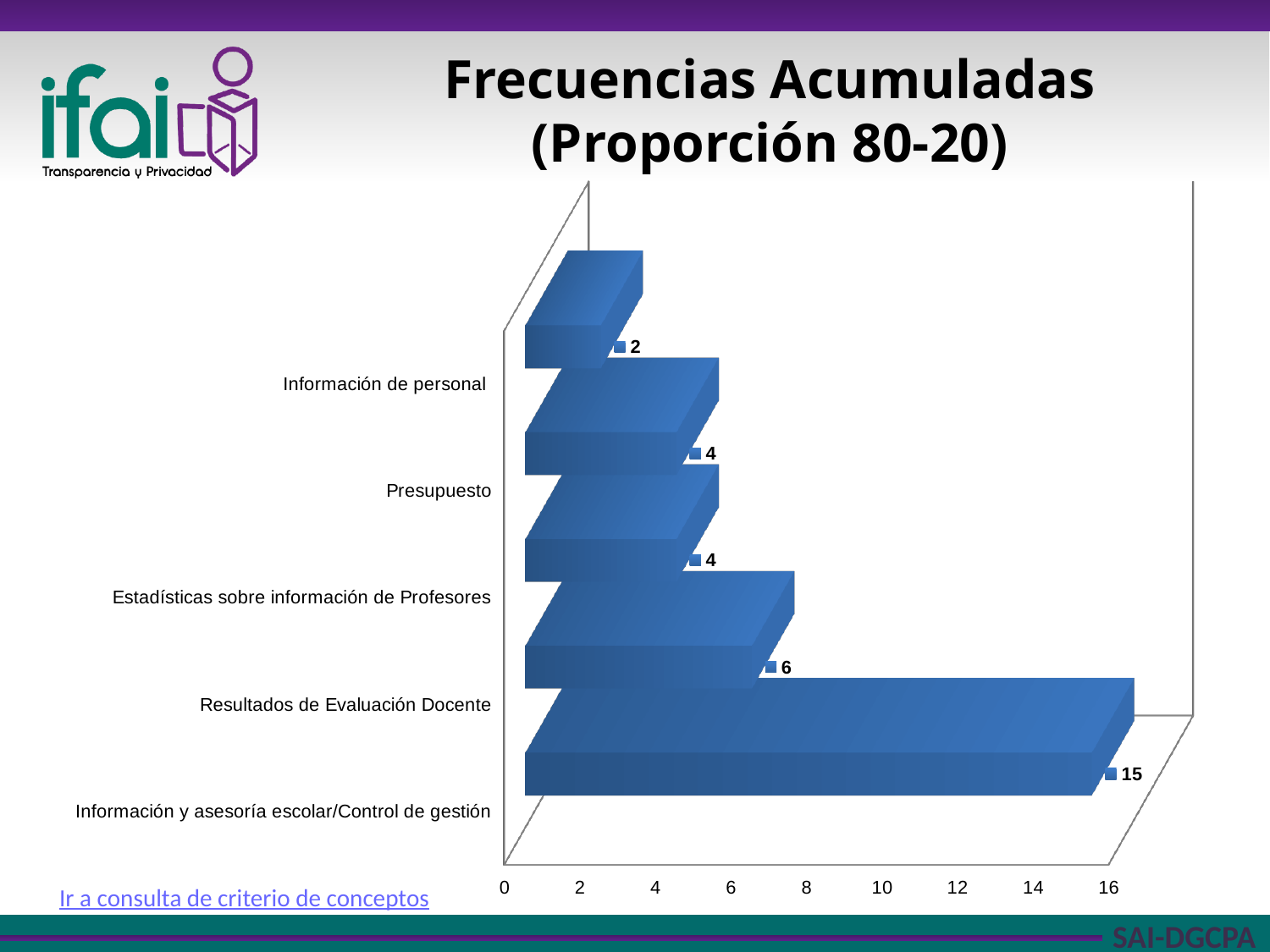
Which category has the highest value? Información y asesoría escolar/Control de gestión What is the value for Información y asesoría escolar/Control de gestión? 15 What is the value for Presupuesto? 4 Which category has the lowest value? Información de personal Which is larger, the value for Resultados de Evaluación Docente or the value for Presupuesto? Resultados de Evaluación Docente What is the title of the chart? Frecuencias Acumuladas (Proporción 80-20) What kind of chart is shown on the slide? bar chart How many categories are shown in the chart? 5 What is the value for Resultados de Evaluación Docente? 6 Is the value for Información y asesoría escolar/Control de gestión greater or less than 10? greater What is the difference between the values for Información y asesoría escolar/Control de gestión and Resultados de Evaluación Docente? 9 What is the value for Información de personal? 2